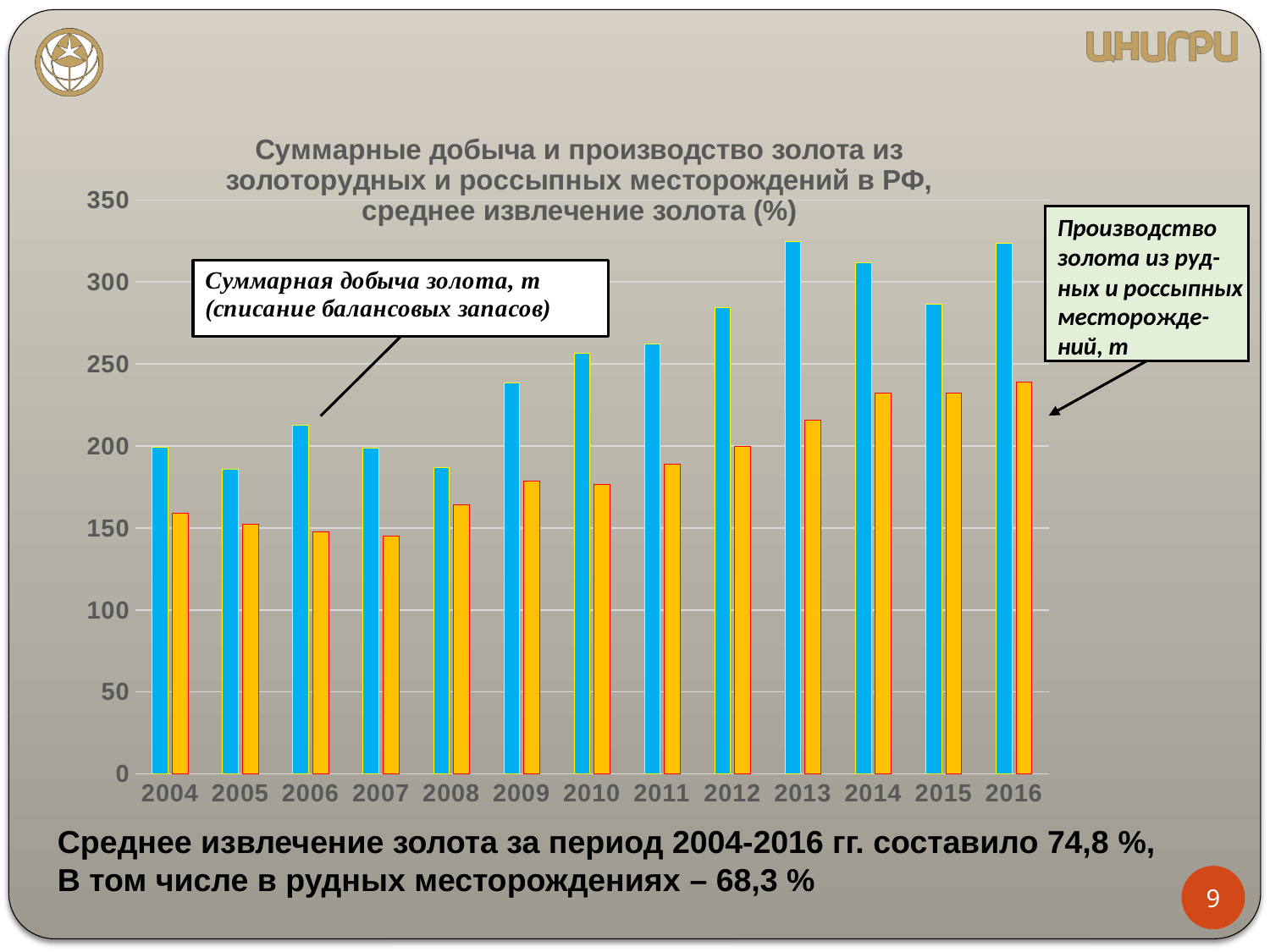
How many data series are plotted in the chart? 2 Is the value of the blue series (Суммарная добыча золота, т) for 2013 greater or less than 300? greater Which is larger in 2010: the blue bar (Суммарная добыча золота) or the orange bar (Производство золота)? the blue bar (Суммарная добыча золота) Is the value of the blue series (Суммарная добыча золота) for 2012 greater or less than 250? greater Is the value of the orange series (Производство золота) for 2016 greater or less than 250? less How many years are shown on the x axis of the chart? 13 Does the orange series (Производство золота) generally rise or fall from 2007 to 2016? rise Which year has the highest value for the orange series (Производство золота из рудных и россыпных месторождений, т)? 2016 What kind of chart is shown on the slide? bar chart Which year has the larger value for the blue series (Суммарная добыча золота): 2004 or 2013? 2013